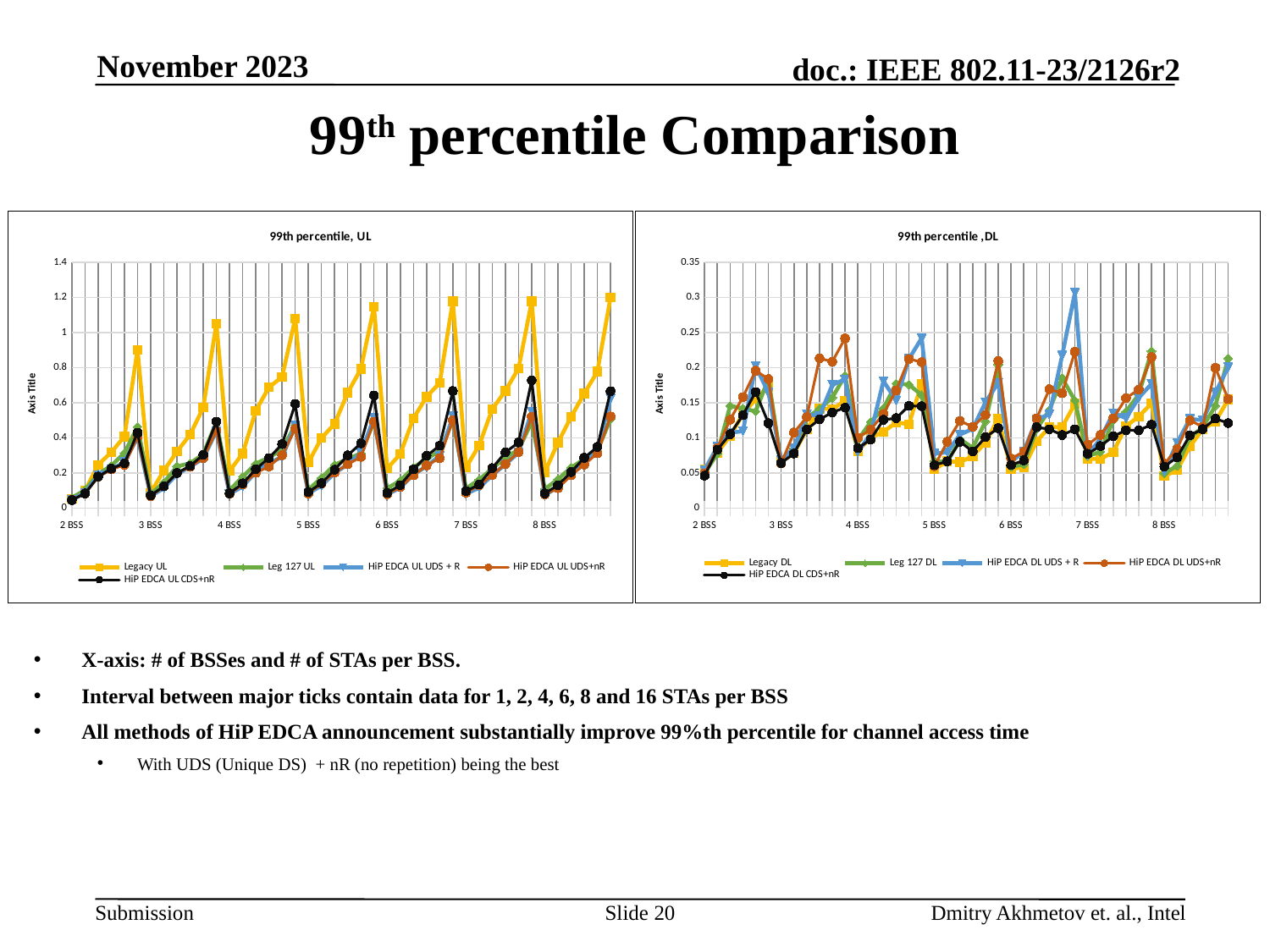
In the "99th percentile, UL" chart, do the peak values of Legacy UL rise or fall from 2 BSS to 8 BSS? rise How many BSS labels are shown on the x-axis of the "99th percentile, UL" chart? 7 What is the title of the left chart on the slide? 99th percentile, UL In the "99th percentile, UL" chart, which series reaches the highest values overall? Legacy UL In the "99th percentile ,DL" chart, is the highest peak of HiP EDCA DL UDS + R near 7 BSS greater or less than 0.25? greater In the "99th percentile, UL" chart, at the peak near 8 BSS, which is higher: Legacy UL or HiP EDCA UL CDS+nR? Legacy UL How many series does the legend of the "99th percentile ,DL" chart list? 5 In the "99th percentile, UL" chart, is the highest value of Legacy UL near 8 BSS greater or less than 1? greater What type of chart is the left chart titled "99th percentile, UL"? line chart What type of chart is the right chart titled "99th percentile ,DL"? line chart What is the maximum value shown on the y-axis of the "99th percentile ,DL" chart? 0.35 How many series does the legend of the "99th percentile, UL" chart list? 5